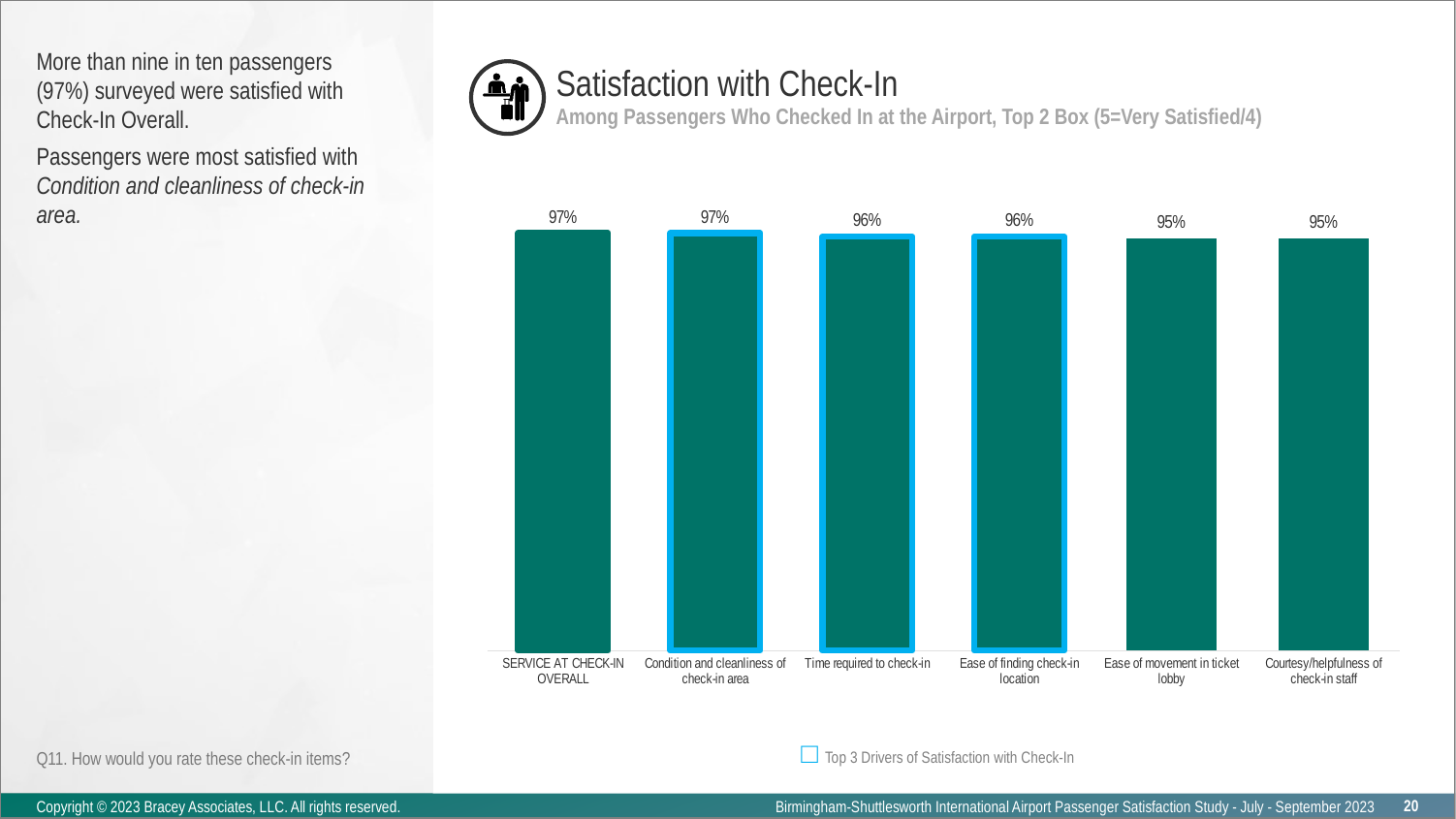
What is the value for Time required to check-in? 96% What is the value for Courtesy/helpfulness of check-in staff? 95% What is the value for Ease of movement in ticket lobby? 95% What is the value for Ease of finding check-in location? 96% What is the value for Condition and cleanliness of check-in area? 97% How many categories are shown in the chart? 6 Which is larger, the value for Condition and cleanliness of check-in area or the value for Courtesy/helpfulness of check-in staff? Condition and cleanliness of check-in area Do the values rise or fall moving from left to right across the chart? Fall What is the value for SERVICE AT CHECK-IN OVERALL? 97% What kind of chart is shown on the slide? Bar chart How many bars are outlined in blue as Top 3 Drivers of Satisfaction with Check-In? 3 What is the difference between the value for SERVICE AT CHECK-IN OVERALL and the value for Ease of movement in ticket lobby? 2 percentage points